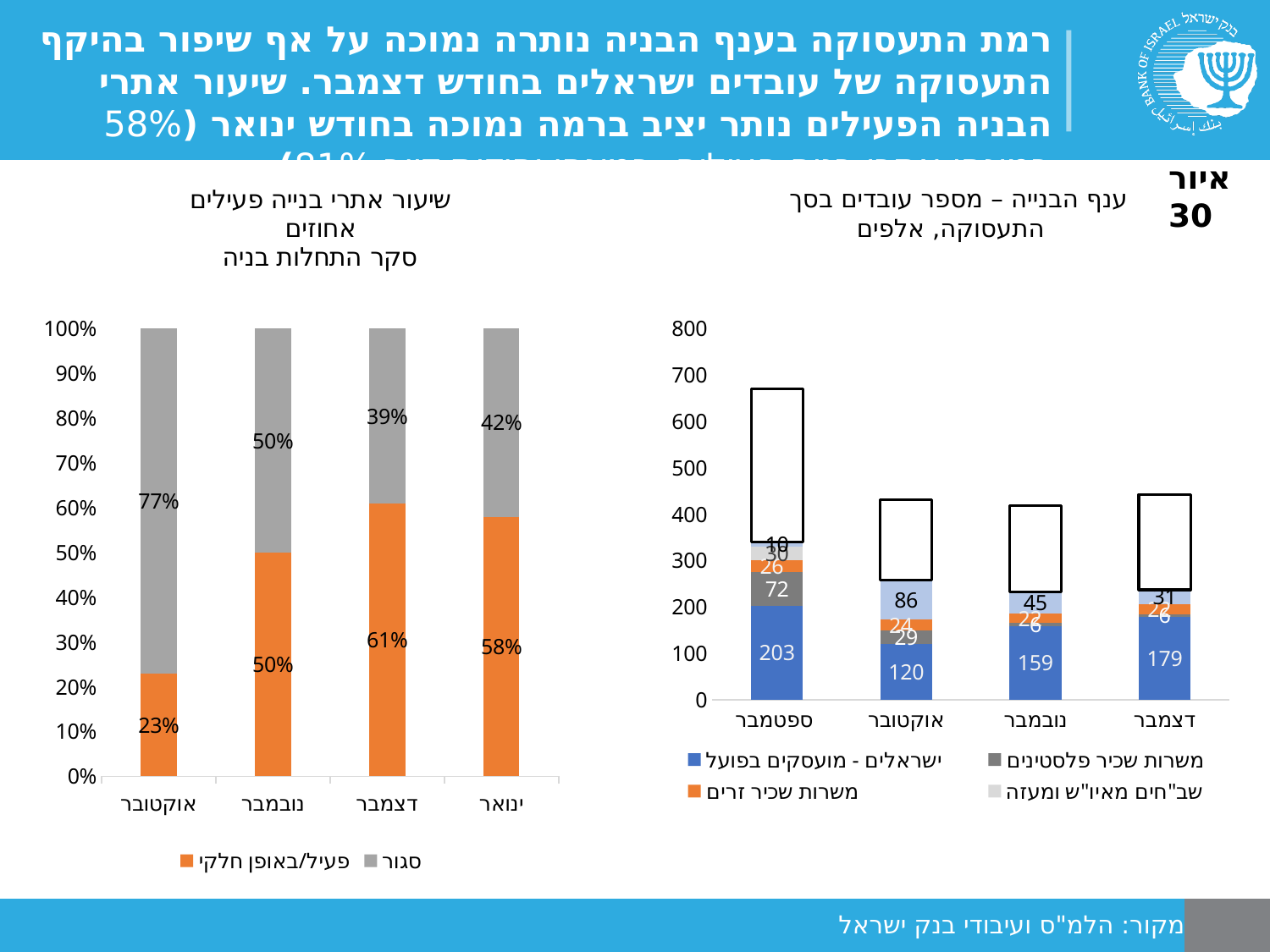
In the chart 'שיעור אתרי בנייה פעילים', how many months are shown on the x axis? 4 In the chart 'ענף הבנייה – מספר עובדים בסך התעסוקה', is the value for ישראלים - מועסקים בפועל in דצמבר greater or less than 200? less In the chart 'ענף הבנייה – מספר עובדים בסך התעסוקה', which month has the lowest value for ישראלים - מועסקים בפועל? אוקטובר In the chart 'ענף הבנייה – מספר עובדים בסך התעסוקה', what is the difference between the ישראלים - מועסקים בפועל values in ספטמבר and אוקטובר? 83 In the chart 'שיעור אתרי בנייה פעילים', which month has the lowest share of active/partially active sites? אוקטובר In the chart 'שיעור אתרי בנייה פעילים', what is the difference between the active share in דצמבר and the active share in ינואר? 3% In the chart 'שיעור אתרי בנייה פעילים', what is the share of active/partially active sites (פעיל/באופן חלקי) in דצמבר? 61% In the chart 'ענף הבנייה – מספר עובדים בסך התעסוקה', what is the value for ישראלים - מועסקים בפועל in ספטמבר? 203 In the chart 'שיעור אתרי בנייה פעילים', what is the share of closed sites (סגור) in אוקטובר? 77% In the chart 'שיעור אתרי בנייה פעילים', what type of chart is used? stacked bar chart In the chart 'ענף הבנייה – מספר עובדים בסך התעסוקה', how many series does the legend list? 4